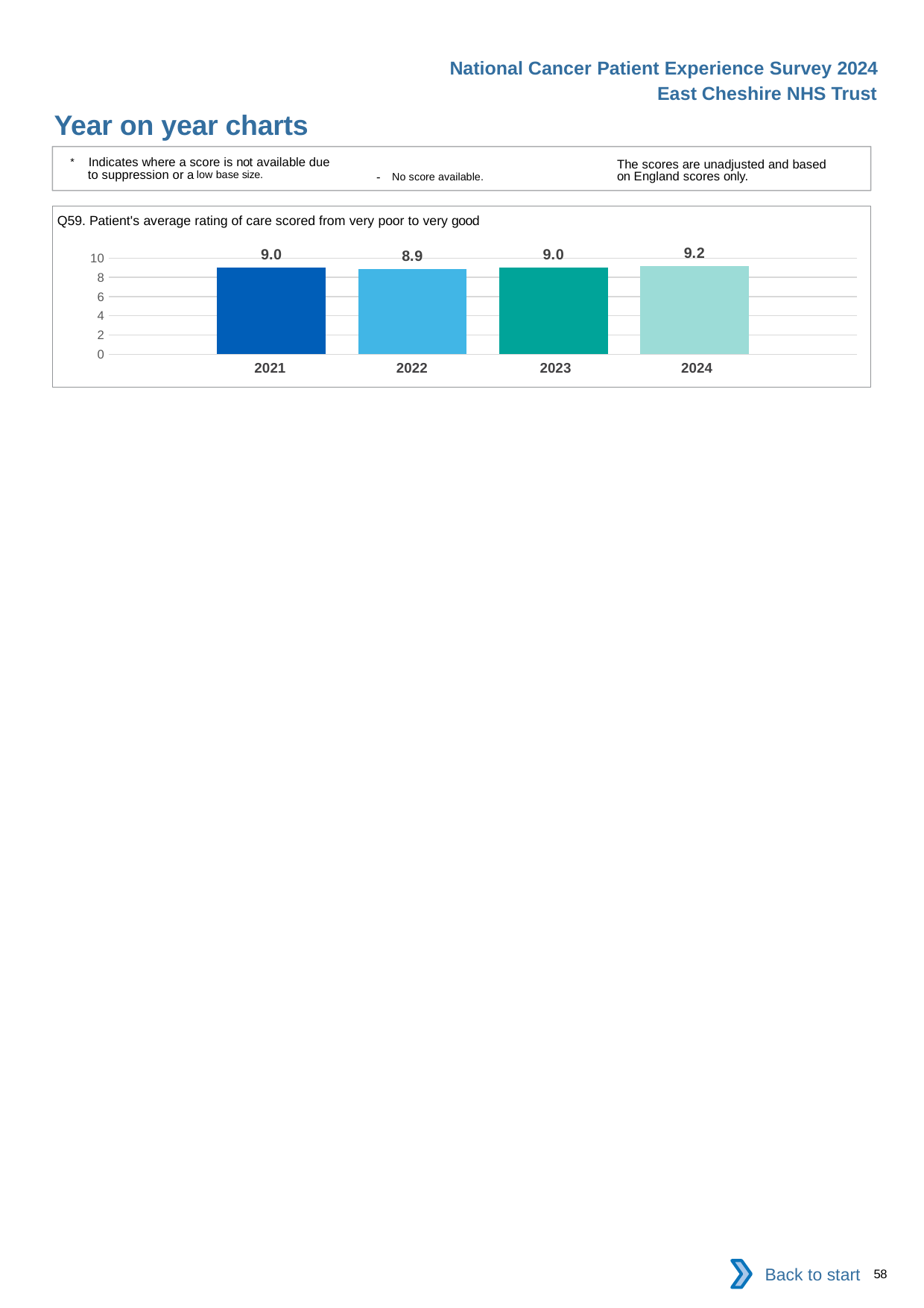
What is the title of the chart? Q59. Patient's average rating of care scored from very poor to very good Is the value for 2022 greater or less than 8? greater Which is larger, the value for 2023 or the value for 2024? 2024 Do the values rise or fall from 2022 to 2024? rise What kind of chart is shown? bar chart Which year has the lowest value? 2022 What is the difference between the values for 2024 and 2022? 0.3 What is the value for 2021? 9.0 What is the value for 2022? 8.9 Which year has the highest value? 2024 How many years are shown on the chart? 4 What is the value for 2024? 9.2